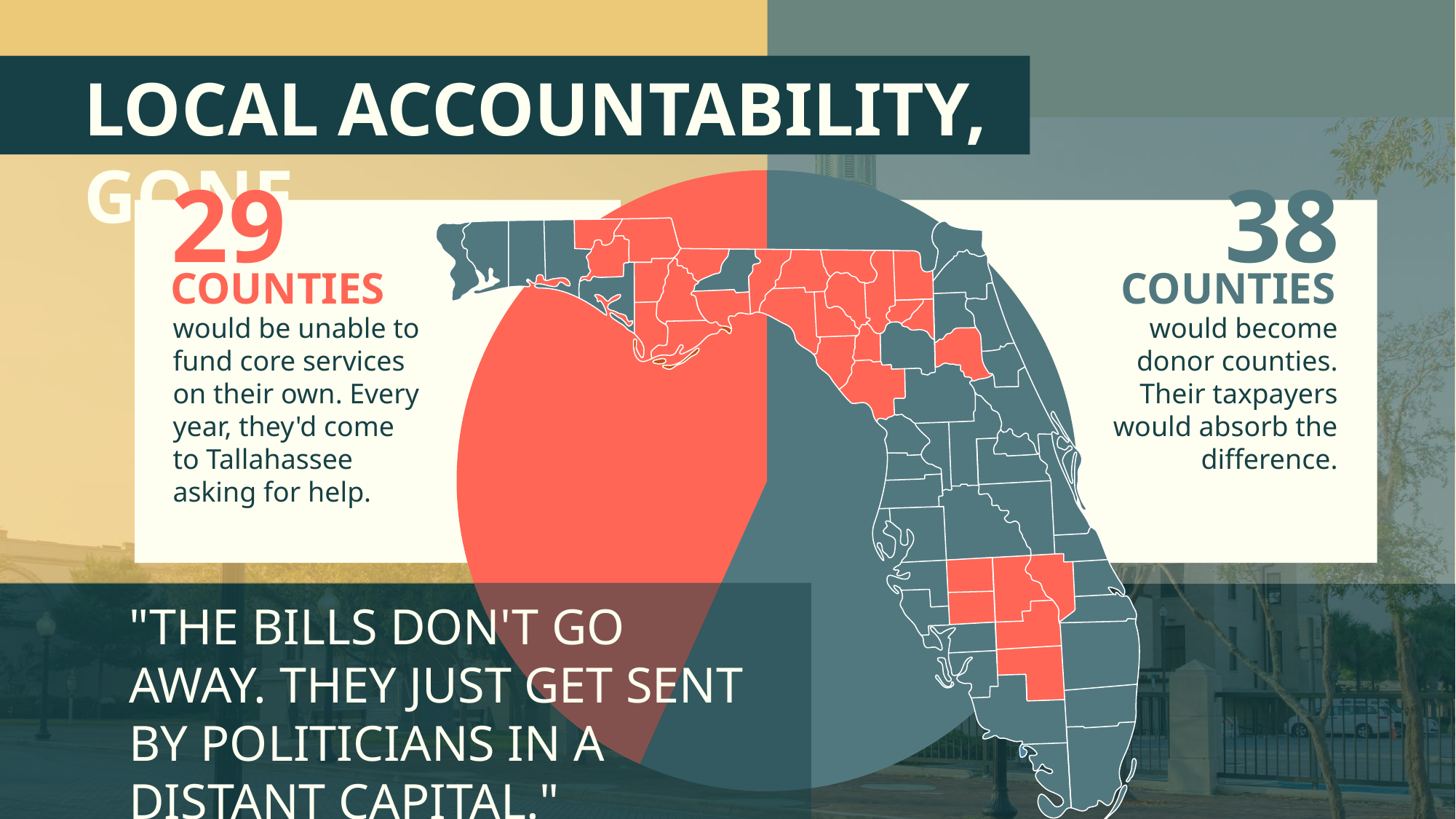
Which slice of the pie chart is larger, the red slice (counties unable to fund core services) or the dark teal slice (donor counties)? the dark teal slice (38 counties) What colour is used for the counties that would be unable to fund core services on their own? red What is the title at the top of the slide? LOCAL ACCOUNTABILITY, GONE How many slices does the pie chart on the slide have? 2 What kind of chart is shown behind the map of Florida on the slide? pie chart What is the total number of counties represented by the two slices of the pie chart? 67 Which group of counties is the largest in the pie chart? the 38 donor counties How many counties does the red slice of the pie chart represent? 29 How many counties does the dark teal slice of the pie chart represent? 38 Which group of counties is the smallest in the pie chart? the 29 counties unable to fund core services What is the difference between the number of donor counties and the number of counties unable to fund core services on their own? 9